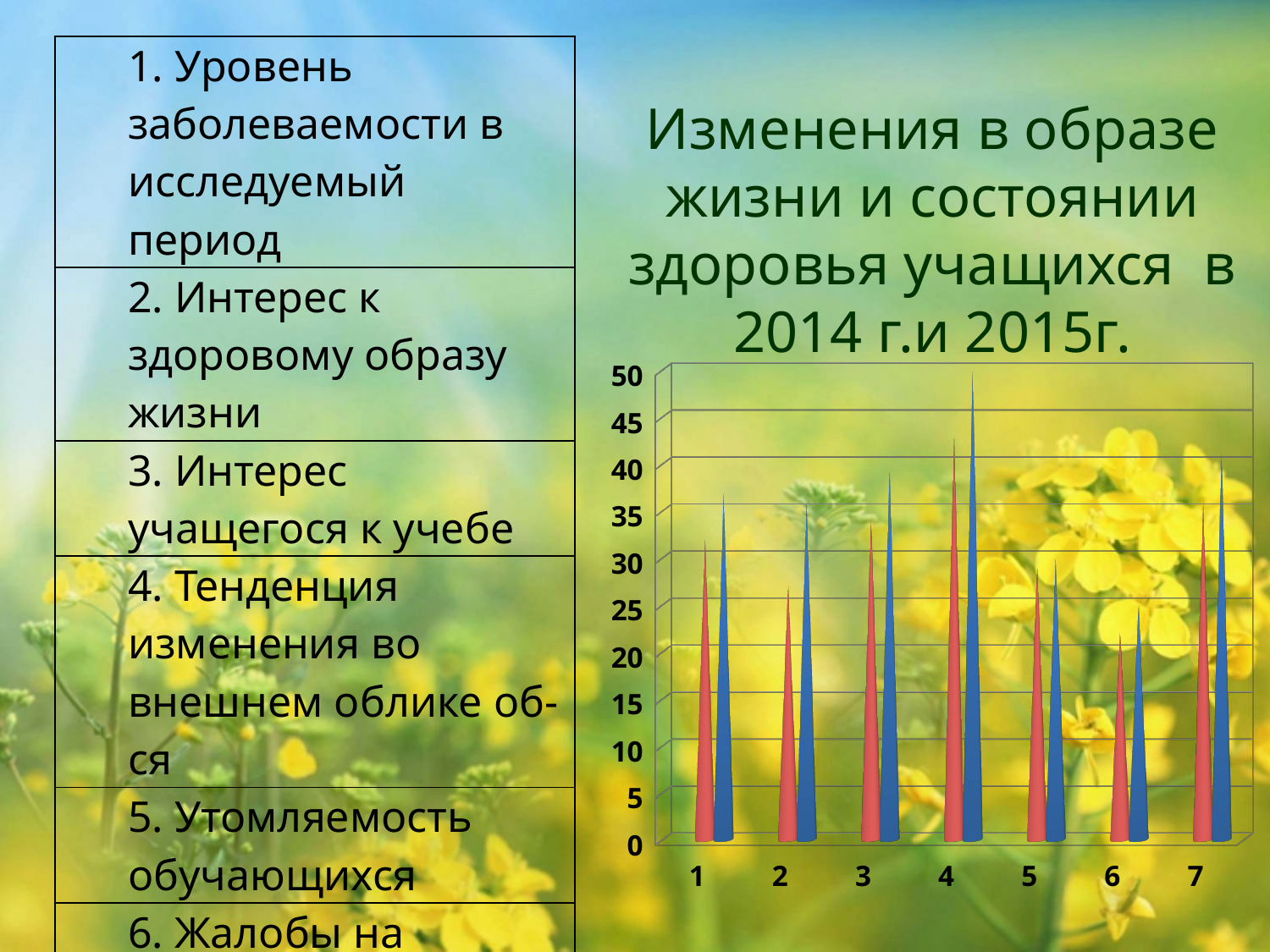
Which category has the shortest red bar in the chart? 6 What kind of chart is shown on the slide? bar chart Is the value of the blue bar for category 1 greater or less than 30? greater Which category has the tallest blue bar in the chart? 4 In category 2, which bar is taller, the red one or the blue one? blue Which category has the tallest red bar in the chart? 4 Which category has the shortest blue bar in the chart? 6 Is the value of the red bar for category 6 greater or less than 25? less Is the value of the blue bar for category 4 greater or less than 45? greater What is the title of the chart on the slide? Изменения в образе жизни и состоянии здоровья учащихся в 2014 г.и 2015г. How many series (bar colours) are plotted for each category in the chart? 2 How many categories are shown on the x axis of the chart? 7